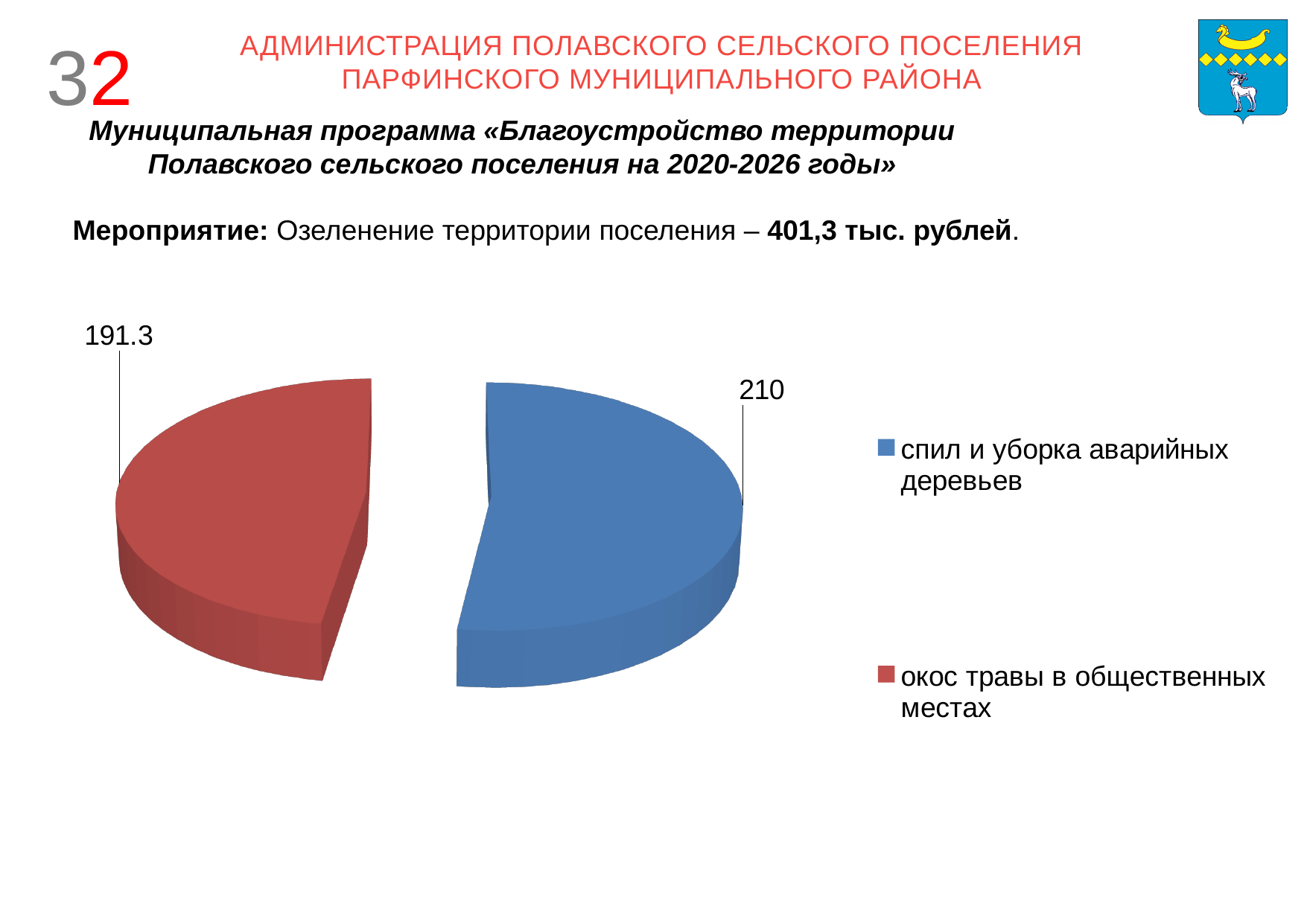
Which category has the smallest slice of the pie? окос травы в общественных местах How many slices does the pie chart have? 2 What is the total of the two slices in the pie chart? 401.3 Which is larger: «спил и уборка аварийных деревьев» or «окос травы в общественных местах»? спил и уборка аварийных деревьев What colour is the slice for «окос травы в общественных местах»? red Which category has the largest slice of the pie? спил и уборка аварийных деревьев How many entries does the legend list? 2 What is the value for «спил и уборка аварийных деревьев»? 210 What is the difference between the values for «спил и уборка аварийных деревьев» and «окос травы в общественных местах»? 18.7 What colour is the slice for «спил и уборка аварийных деревьев»? blue What is the value for «окос травы в общественных местах»? 191.3 What kind of chart is shown on the slide? pie chart